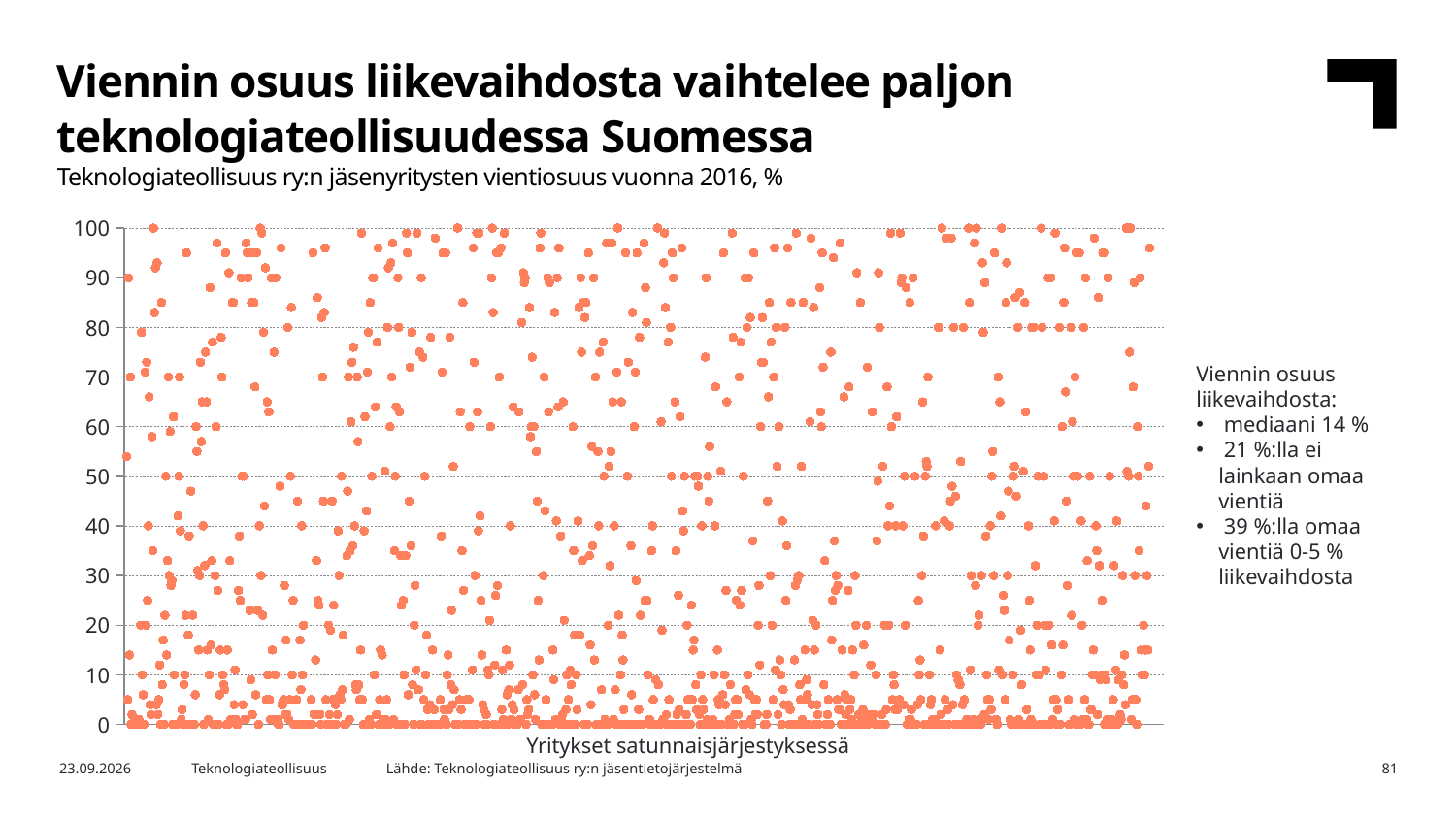
What is the highest export share value plotted in the chart? 100 What colour are the data points in the chart? orange What is the label of the horizontal axis of the chart? Yritykset satunnaisjärjestyksessä What is the lowest export share value plotted in the chart? 0 What kind of chart is shown on the slide? scatter chart